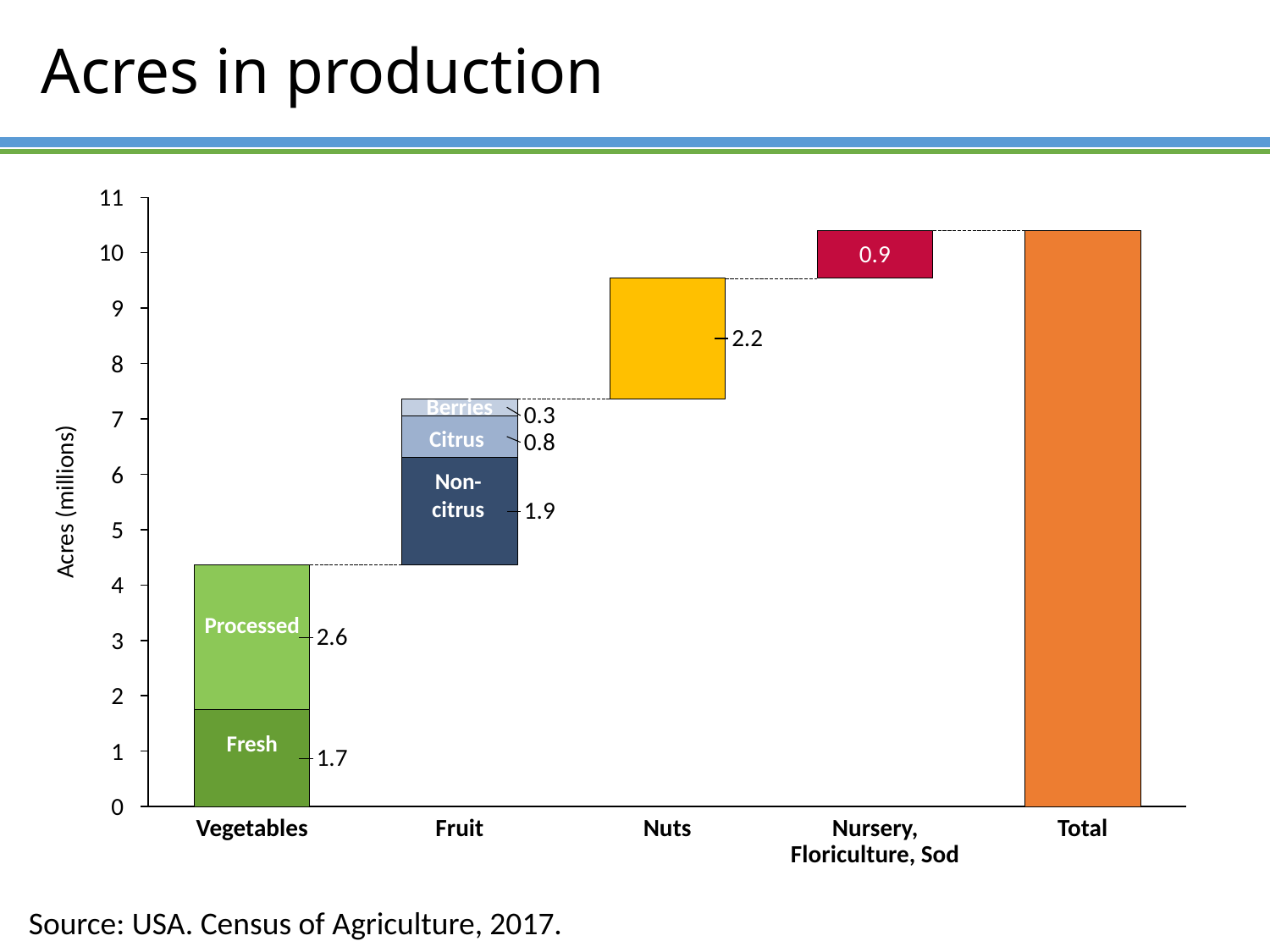
What is the label on the y axis? Acres (millions) How much larger is Processed than Fresh within Vegetables? 0.9 What is the total of the Fruit bar (Non-citrus, Citrus and Berries)? 3.0 What is the value for Nuts? 2.2 What is the value for Processed vegetables? 2.6 Which is larger, Nuts or Nursery, Floriculture, Sod? Nuts What is the value for Non-citrus fruit? 1.9 What is the value for Nursery, Floriculture, Sod? 0.9 What is the total of the Vegetables bar (Fresh plus Processed)? 4.3 What is the value for Fresh vegetables? 1.7 Is the value of the Total bar greater or less than 10? greater What is the value for Berries? 0.3